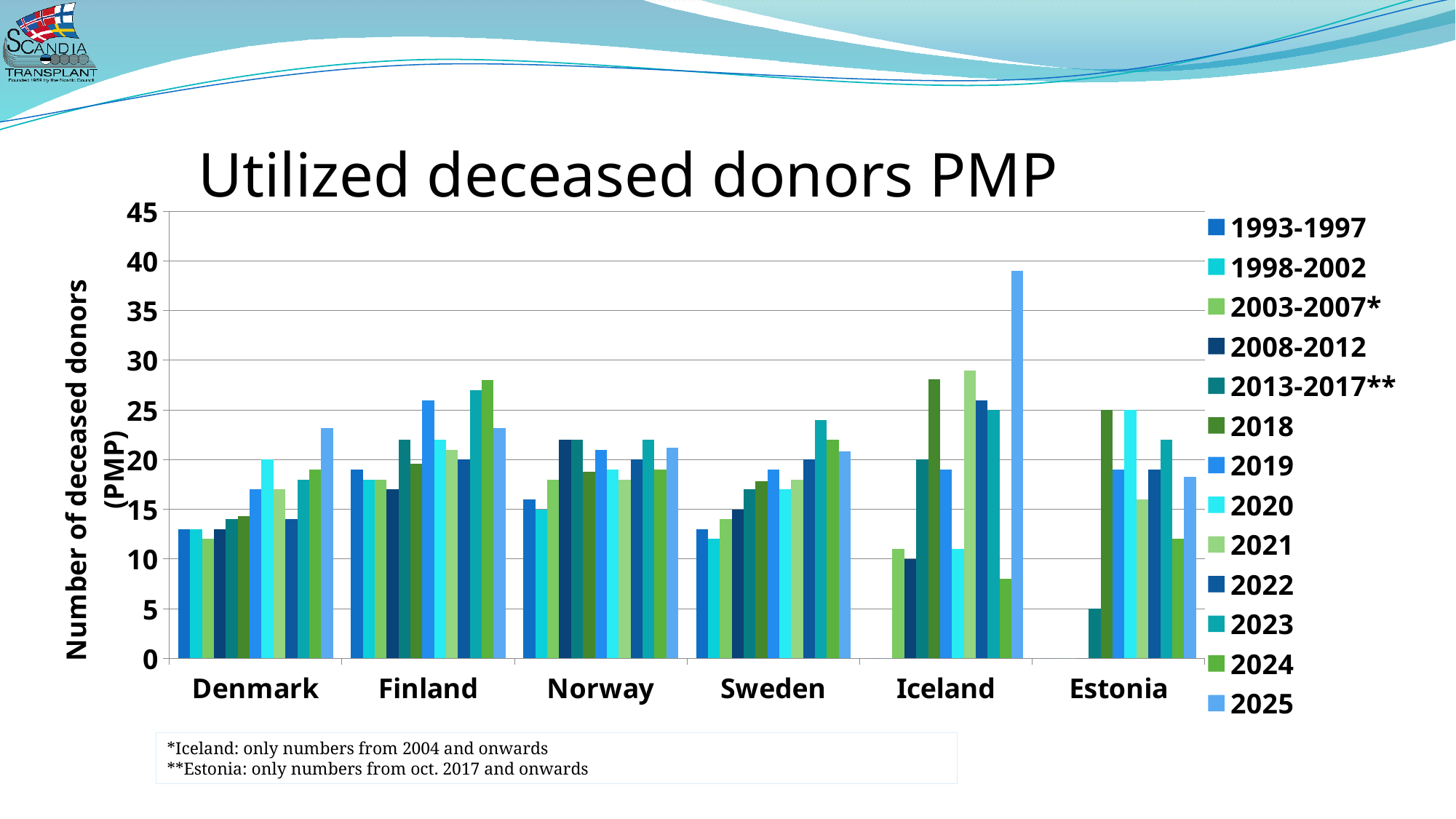
Is the value for Finland in 2024 greater or less than 25? greater Is the value for Iceland in 2025 greater or less than 35? greater What kind of chart is shown on the slide? bar chart Is the value for Estonia in 2013-2017** greater or less than 10? less What is the label on the vertical axis? Number of deceased donors (PMP) Which is larger, the 2019 value for Finland or the 2019 value for Denmark? Finland Which series has the lowest bar for Estonia? 2013-2017** How many series does the legend list? 13 What is the title of the chart? Utilized deceased donors PMP How many countries are shown on the x axis of the chart? 6 Which country has the tallest bar for 2025? Iceland Which is larger for Estonia, the 2020 value or the 2024 value? 2020